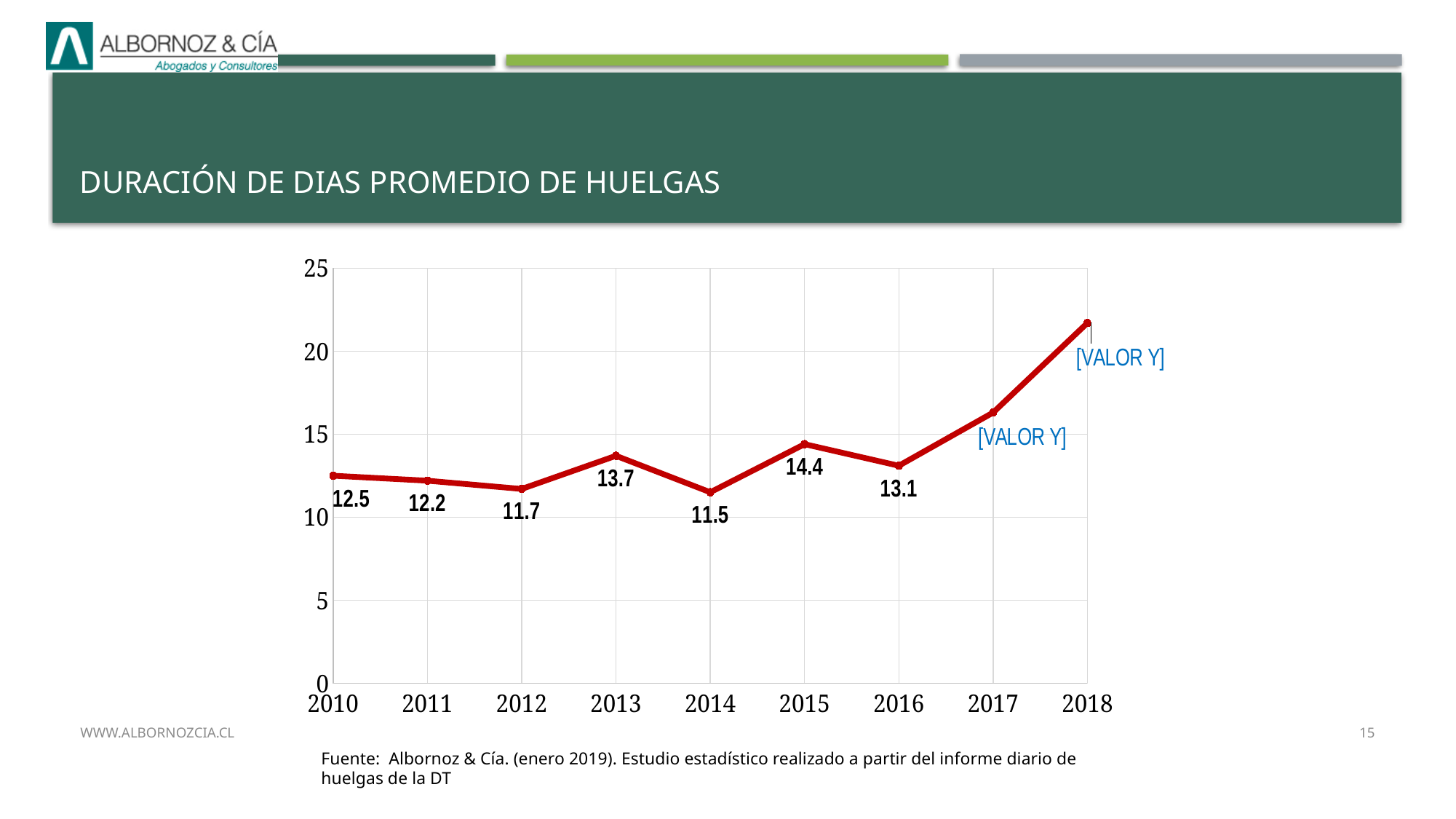
Which is larger, the value for 2013 or the value for 2016? 2013 Is the value for 2018 greater or less than 20? greater How many years are plotted on the x axis? 9 What is the value for 2015? 14.4 Do the values rise or fall from 2016 to 2018? rise Is the value for 2017 greater or less than 15? greater What is the value for 2014? 11.5 Which year has the lowest value? 2014 What is the value for 2010? 12.5 What is the difference between the values for 2015 and 2014? 2.9 Which year has the highest value? 2018 What kind of chart is shown? line chart